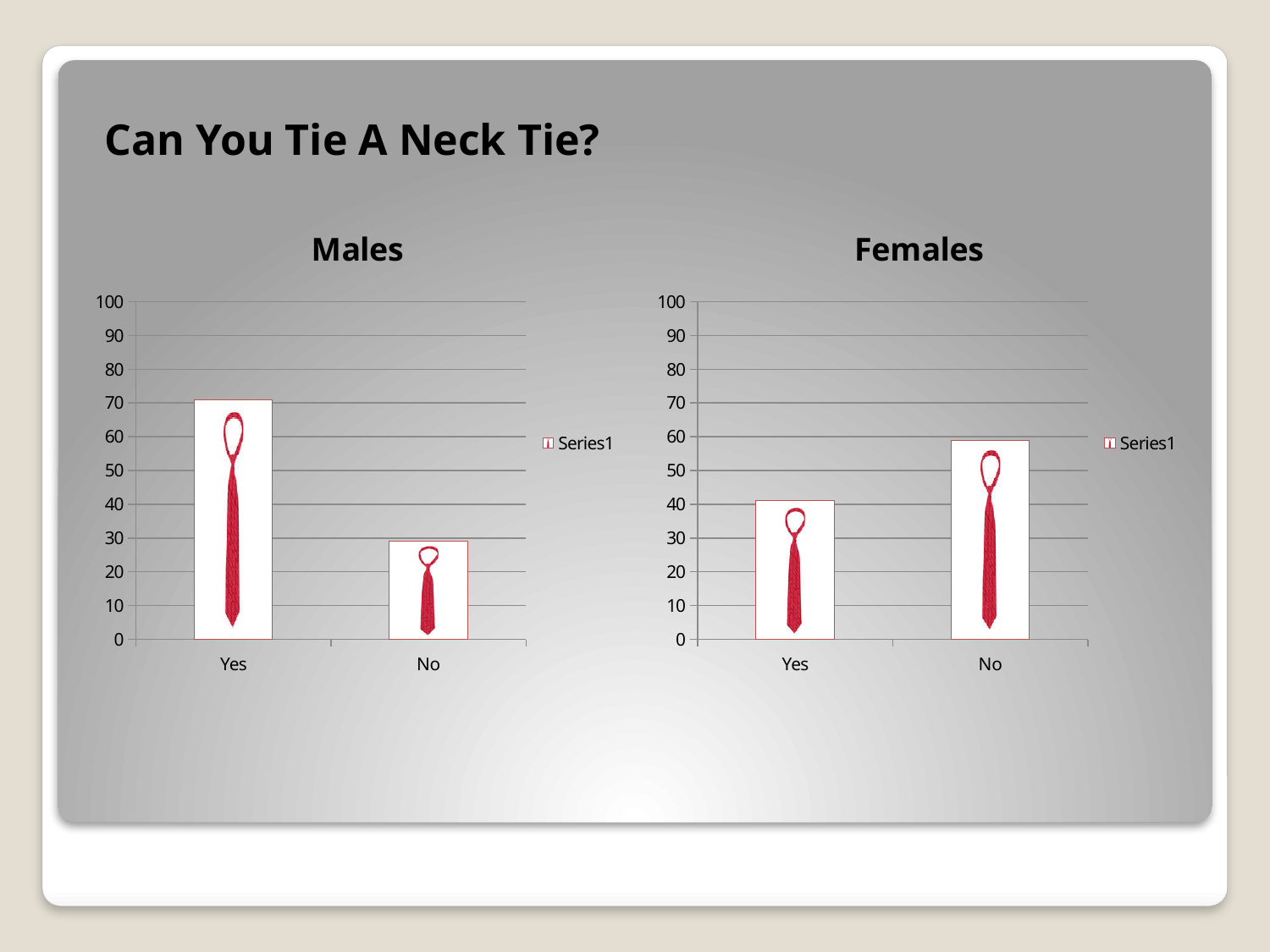
What is the highest value shown on the y axis of the Males chart? 100 What is the title of the chart on the right side of the slide? Females How many categories are shown on the x axis of the Males chart? 2 What kind of chart is the Males chart? bar chart In the Females chart, which is larger, the value for Yes or the value for No? No In the Males chart, is the value for Yes greater or less than 60? greater In the Females chart, is the value for Yes greater or less than 50? less In the Males chart, is the value for No greater or less than 40? less In the Males chart, which category has the higher value? Yes In the Females chart, which category has the lower value? Yes How many series does the legend of the Females chart list? 1